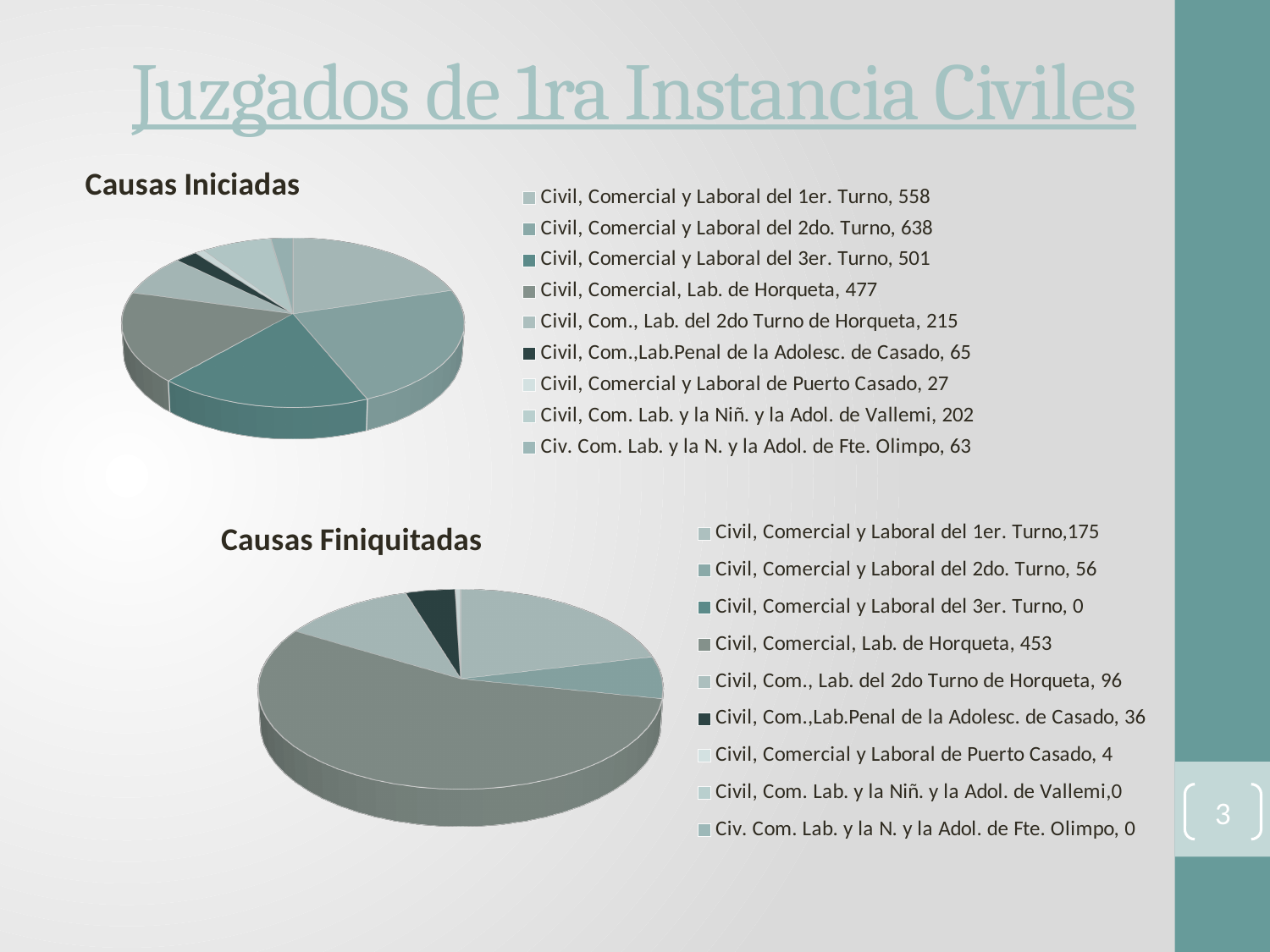
In the Causas Iniciadas chart, what is the value for Civil, Comercial y Laboral del 2do. Turno? 638 In the Causas Finiquitadas chart, what is the difference between Civil, Comercial y Laboral del 1er. Turno and Civil, Comercial y Laboral del 2do. Turno? 119 In the Causas Iniciadas chart, which category has the highest value? Civil, Comercial y Laboral del 2do. Turno In the Causas Finiquitadas chart, what is the total of all the listed values? 820 In the Causas Iniciadas chart, what is the difference between the values for the 2do. Turno and the 1er. Turno of Civil, Comercial y Laboral? 80 In the Causas Iniciadas chart, which category has the lowest value? Civil, Comercial y Laboral de Puerto Casado In the Causas Finiquitadas chart, what is the value for Civil, Comercial, Lab. de Horqueta? 453 In the Causas Finiquitadas chart, which category has the highest value? Civil, Comercial, Lab. de Horqueta What kind of chart is the Causas Iniciadas chart? Pie chart What is the title of the slide? Juzgados de 1ra Instancia Civiles In the Causas Iniciadas chart, which is larger: Civil, Com. Lab. y la Niñ. y la Adol. de Vallemi or Civil, Com., Lab. del 2do Turno de Horqueta? Civil, Com., Lab. del 2do Turno de Horqueta How many categories does the Causas Finiquitadas chart list in its legend? 9